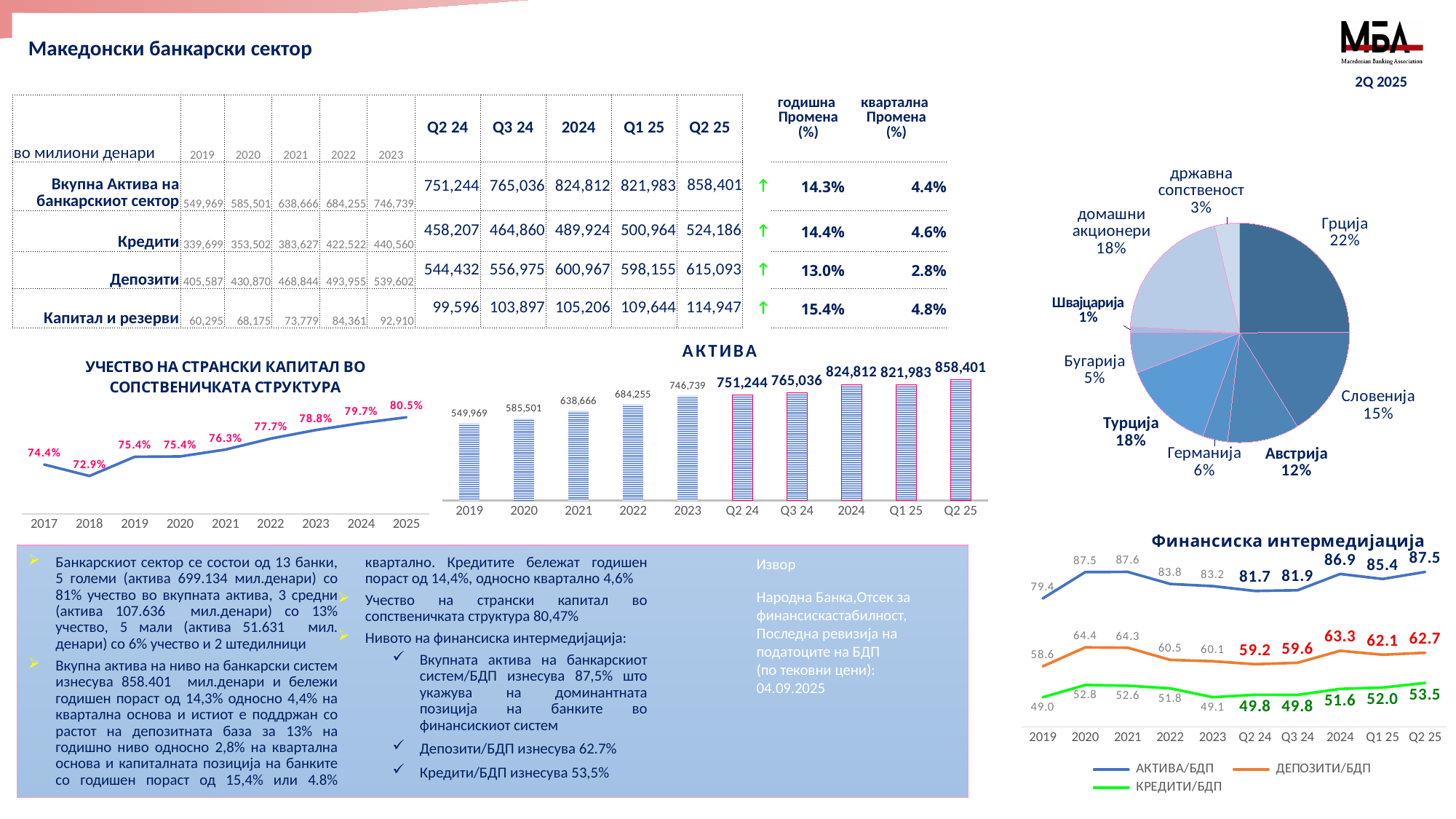
What kind of chart is the 'АКТИВА' chart? Bar chart In the 'УЧЕСТВО НА СТРАНСКИ КАПИТАЛ ВО СОПСТВЕНИЧКАТА СТРУКТУРА' line chart, which year has the lowest value? 2018 In the 'УЧЕСТВО НА СТРАНСКИ КАПИТАЛ ВО СОПСТВЕНИЧКАТА СТРУКТУРА' line chart, what is the value for 2025? 80.5% In the pie chart on the right, which slice is the smallest? Швајцарија In the 'АКТИВА' bar chart, what is the value for Q2 25? 858,401 In the 'АКТИВА' bar chart, which period has the highest value? Q2 25 In the 'АКТИВА' bar chart, what is the value for 2019? 549,969 In the 'Финансиска интермедијација' line chart, what is the value of ДЕПОЗИТИ/БДП for Q2 25? 62.7 In the pie chart on the right, what share does Грција have? 22% In the 'АКТИВА' bar chart, what is the difference between the values for Q2 25 and Q1 25? 36,418 In the 'Финансиска интермедијација' line chart, how many series does the legend list? 3 In the 'УЧЕСТВО НА СТРАНСКИ КАПИТАЛ ВО СОПСТВЕНИЧКАТА СТРУКТУРА' line chart, how many years are shown on the x axis? 9